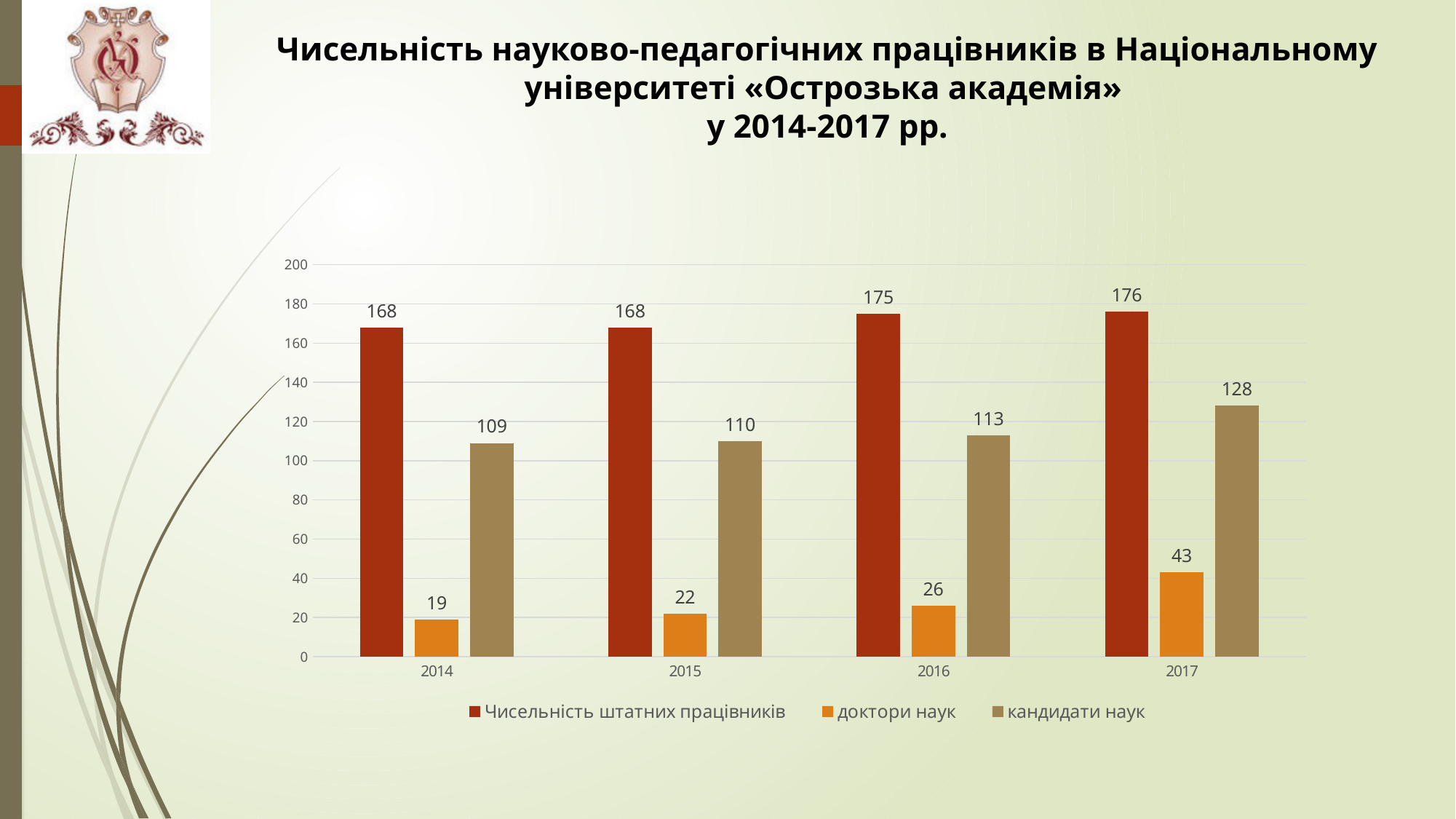
What is the value for "доктори наук" in 2017? 43 How many series does the legend list? 3 What is the value for "Чисельність штатних працівників" in 2016? 175 Is the value for "Чисельність штатних працівників" in 2017 greater or less than 160? greater What is the difference between the "кандидати наук" values for 2017 and 2014? 19 Do the values for "доктори наук" rise or fall from 2014 to 2017? rise What kind of chart is shown on the slide? bar chart How many years are shown on the x axis? 4 In which year is the value for "кандидати наук" highest? 2017 Which is larger: "доктори наук" in 2016 or "доктори наук" in 2015? 2016 In which year is the value for "доктори наук" lowest? 2014 What is the value for "кандидати наук" in 2015? 110